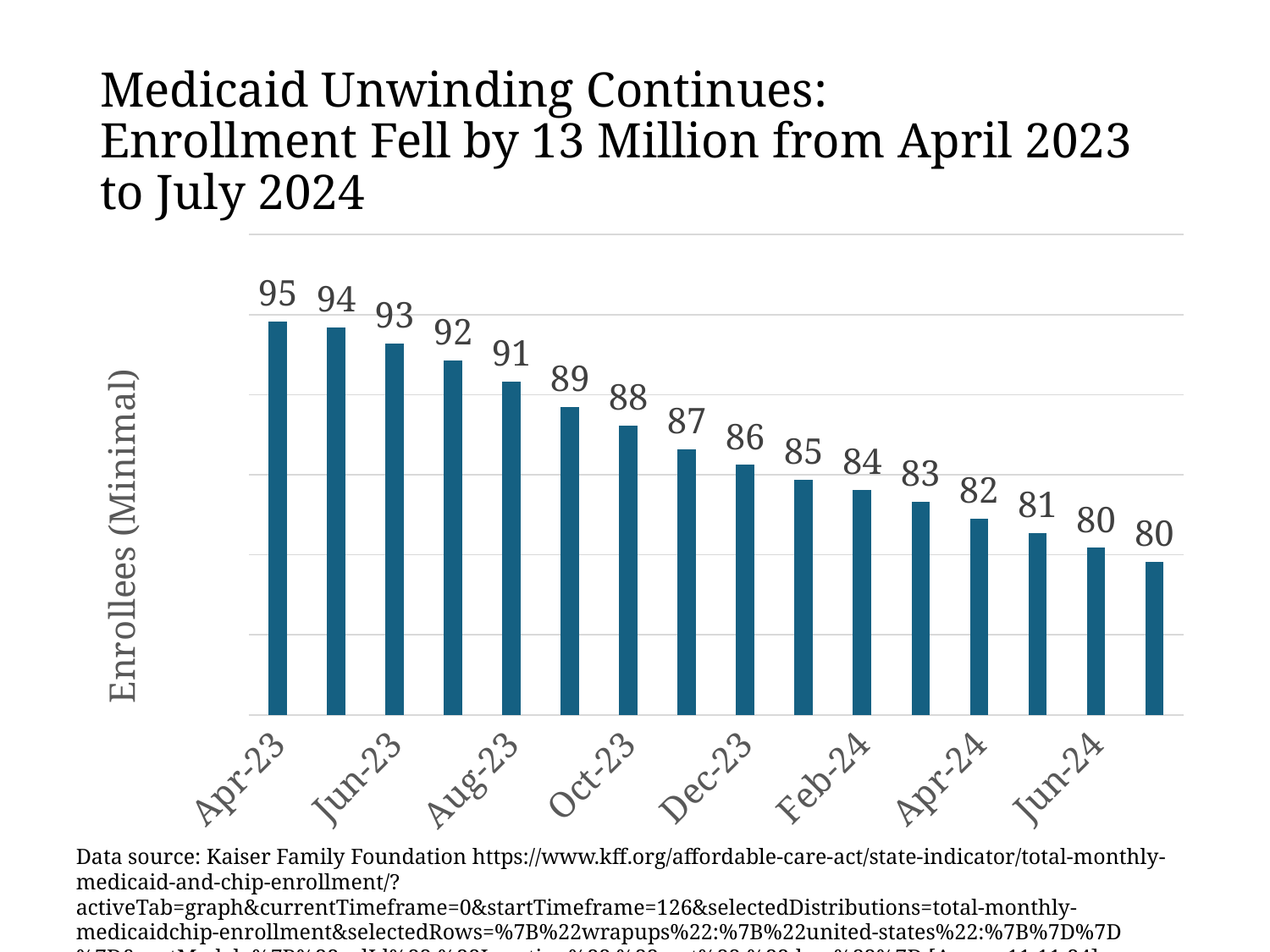
What is the difference between the values for Aug-23 and Dec-23? 5 What kind of chart is shown? bar chart What is the value for Jun-24? 80 What is the value for Feb-24? 84 What is the value for Apr-23? 95 What is the label on the vertical axis? Enrollees (Minimal) Do the values rise or fall from Apr-23 to Jun-24? fall Which is larger, the value for Jun-23 or the value for Apr-24? Jun-23 What is the value for Oct-23? 88 How many bars are plotted in the chart? 16 What is the difference between the values for Apr-23 and Jun-24? 15 Which labeled month has the highest value? Apr-23